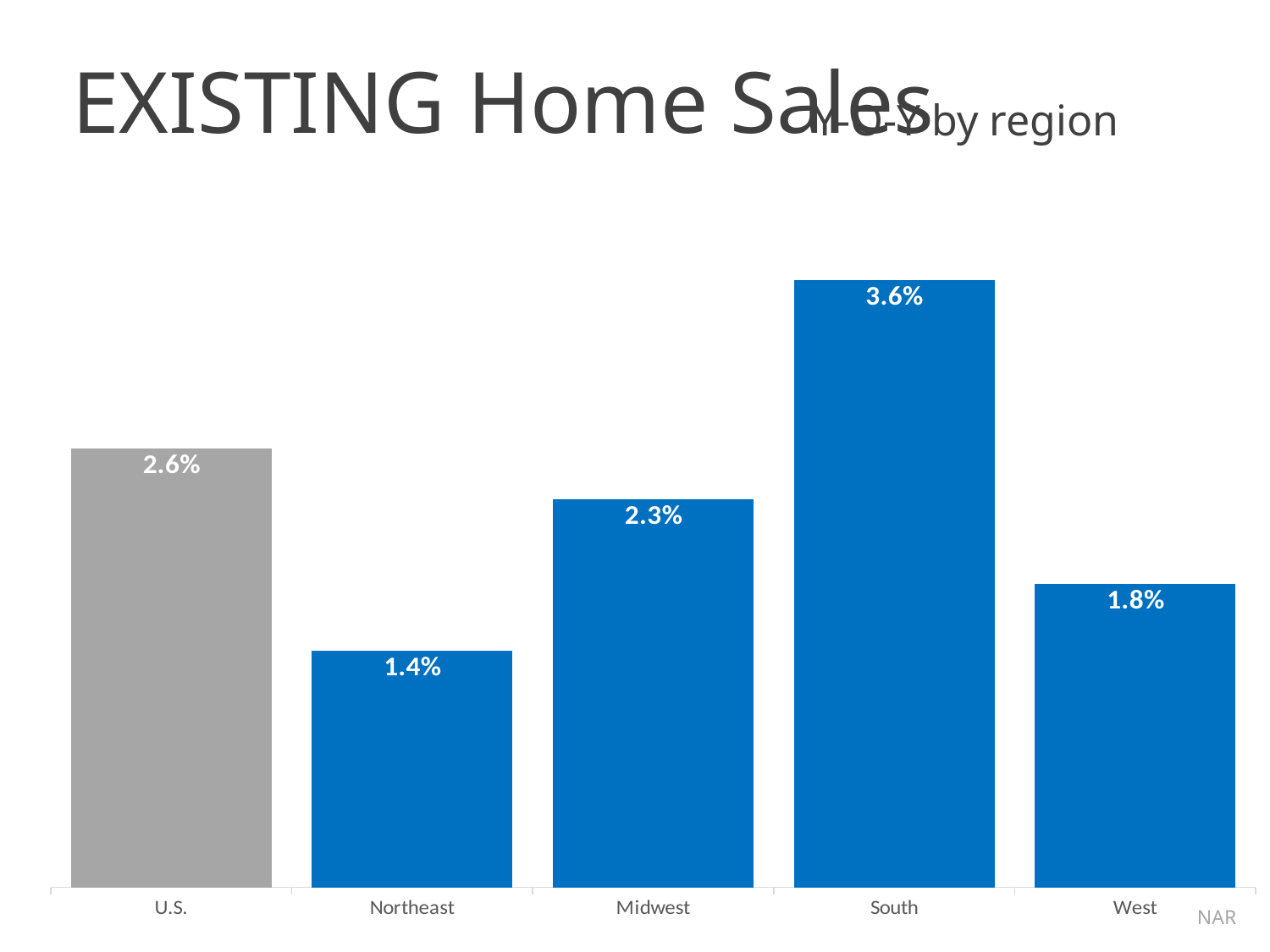
What is the value for the U.S.? 2.6% Which bar is coloured grey rather than blue? U.S. Which category has the lowest value? Northeast Which is larger, the Midwest value or the West value? Midwest What is the value for the Northeast? 1.4% How many categories are shown on the chart? 5 What is the value for the West? 1.8% What is the difference between the South and the Midwest values? 1.3% What is the value for the South? 3.6% What is the difference between the U.S. value and the West value? 0.8% Which region has the highest value? South What kind of chart is shown on the slide? Bar chart